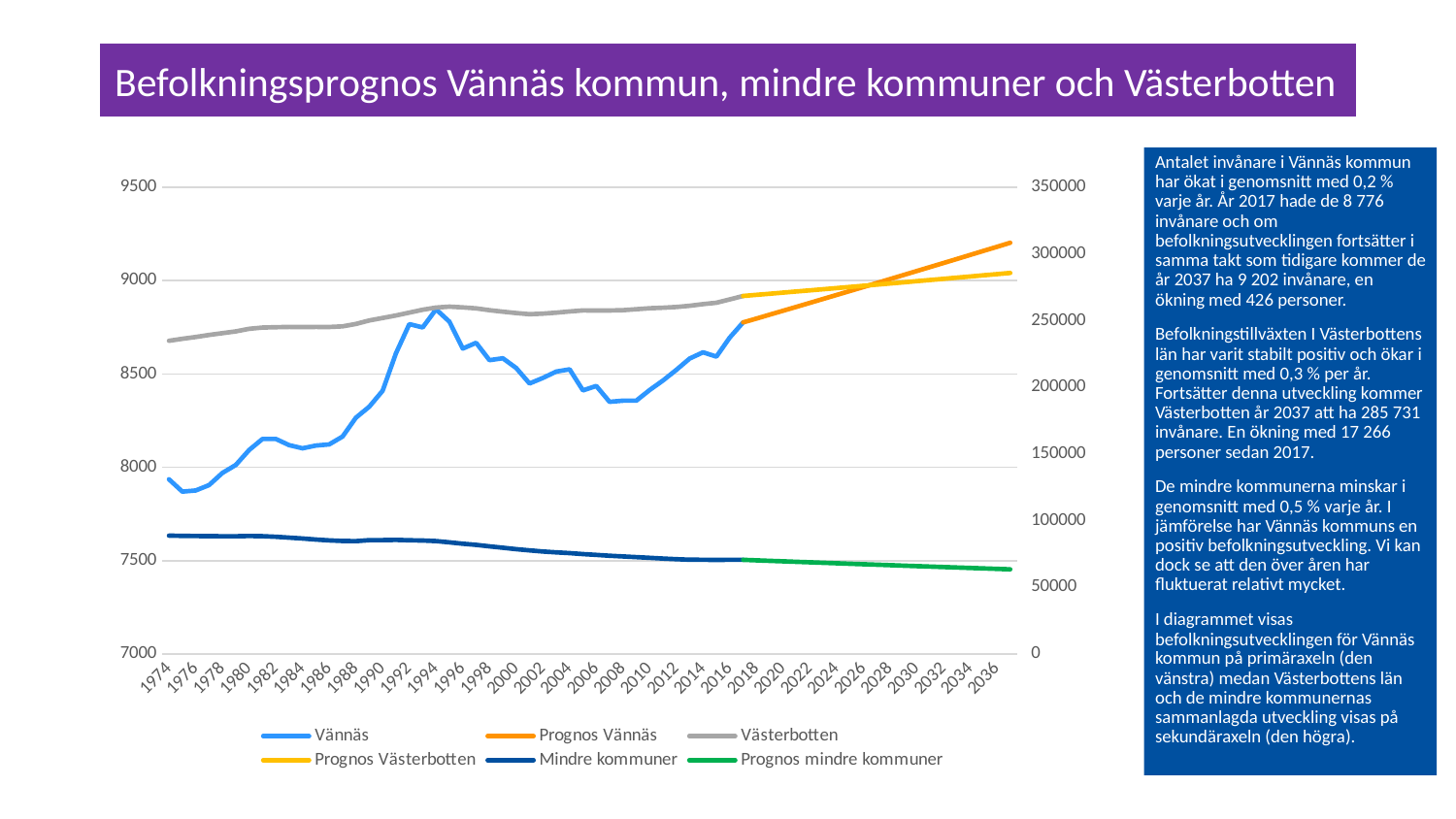
Is the Vännäs value in 1994 greater or less than 8500 on the left axis? greater Which is higher for the Vännäs series: the value in 1994 or the value in 2008? 1994 Does the Prognos mindre kommuner line rise or fall from 2018 to 2036? Fall What is the title of the slide containing the chart? Befolkningsprognos Vännäs kommun, mindre kommuner och Västerbotten How many series does the chart legend list? 6 Does the Mindre kommuner line overall rise or fall between 1974 and 2017? Fall Does the Prognos Vännäs line rise or fall from 2018 to 2036? Rise What is the highest value shown on the left (primary) vertical axis? 9500 Is the Vännäs value in 2008 greater or less than 8500 on the left axis? less What kind of chart is shown on the slide? Line chart Is the Prognos Vännäs value in 2036 greater or less than 9000 on the left axis? greater